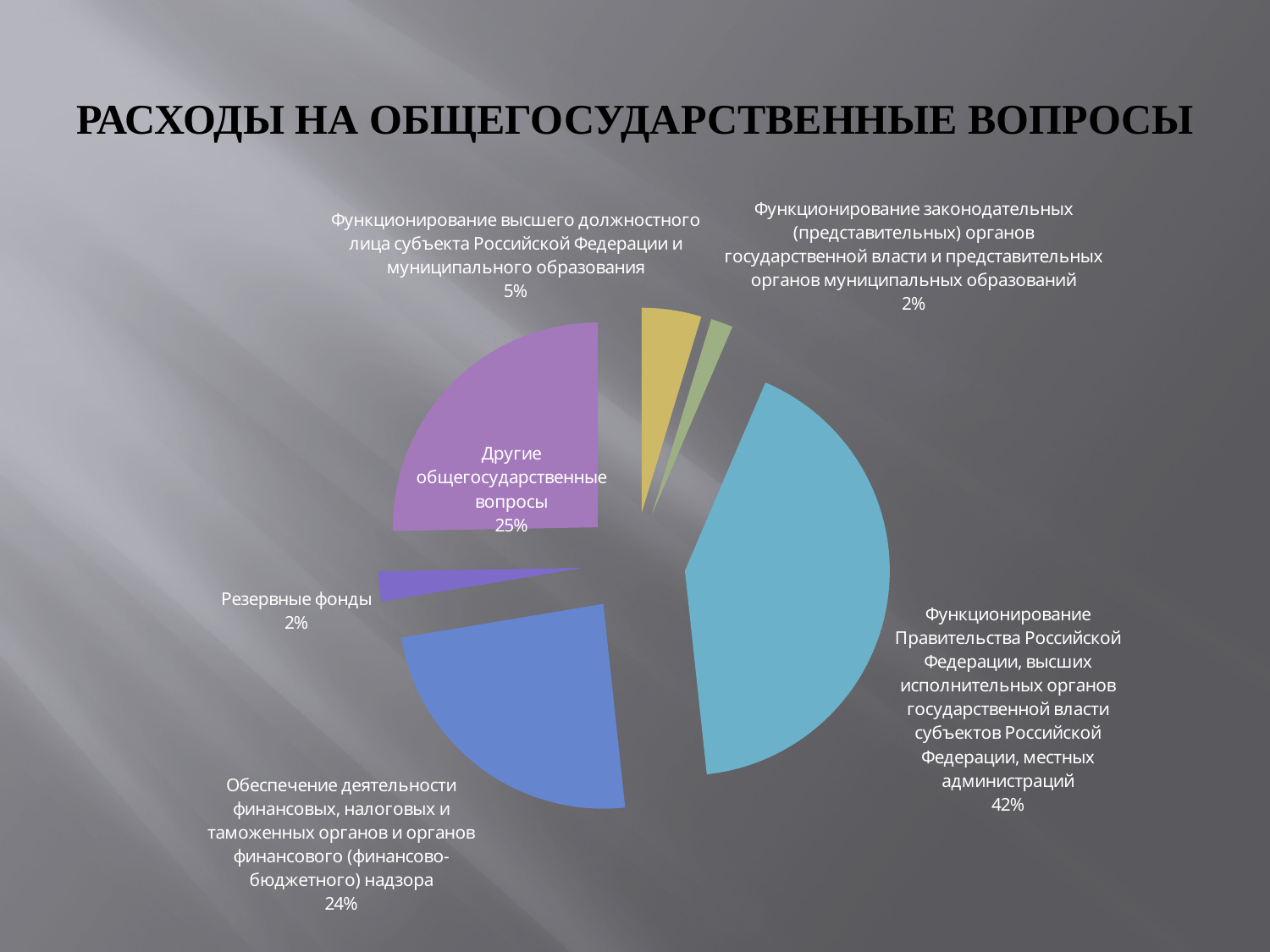
Which is larger: the share for "Другие общегосударственные вопросы" or the share for "Резервные фонды"? Другие общегосударственные вопросы What is the share of the largest slice of the pie? 42% What is the value shown for "Резервные фонды"? 2% What share of the pie is "Другие общегосударственные вопросы"? 25% What is the title of the chart on the slide? РАСХОДЫ НА ОБЩЕГОСУДАРСТВЕННЫЕ ВОПРОСЫ What is the value shown for "Функционирование высшего должностного лица субъекта Российской Федерации и муниципального образования"? 5% What is the difference in percentage points between the largest slice (42%) and "Другие общегосударственные вопросы" (25%)? 17 What is the difference in percentage points between "Другие общегосударственные вопросы" and "Обеспечение деятельности финансовых, налоговых и таможенных органов и органов финансового (финансово-бюджетного) надзора"? 1 What kind of chart is shown on the slide? pie chart Which category has the largest share of the pie? Функционирование Правительства Российской Федерации, высших исполнительных органов государственной власти субъектов Российской Федерации, местных администраций What is the value shown for "Обеспечение деятельности финансовых, налоговых и таможенных органов и органов финансового (финансово-бюджетного) надзора"? 24% How many slices does the pie chart have? 6